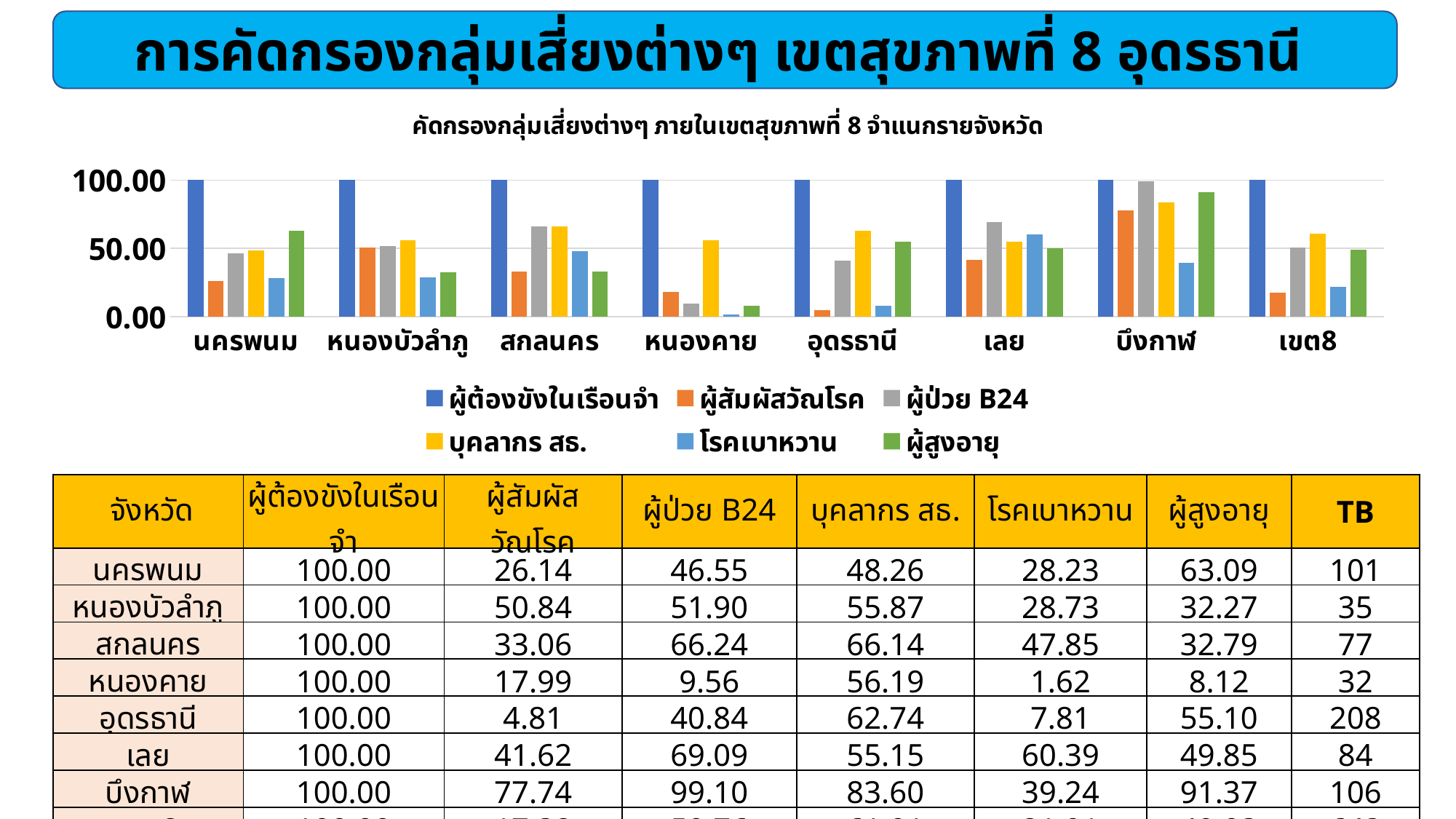
How many series does the chart legend list? 6 What is the value of ผู้สัมผัสวัณโรค for บึงกาฬ? 77.74 How many categories are shown along the x axis of the chart? 8 What is the value of โรคเบาหวาน for เลย? 60.39 What is the value of ผู้ต้องขังในเรือนจำ for สกลนคร? 100.00 What kind of chart is shown on the slide? bar chart Which province has the highest value for ผู้ป่วย B24? บึงกาฬ What colour represents ผู้ต้องขังในเรือนจำ in the chart legend? blue What is the difference between the บุคลากร สธ. value for บึงกาฬ and for หนองคาย? 27.41 Which is larger, the ผู้สูงอายุ value for นครพนม or for หนองบัวลำภู? นครพนม Which province has the lowest value for โรคเบาหวาน? หนองคาย Is the value of ผู้สูงอายุ for บึงกาฬ greater or less than 50.00? greater